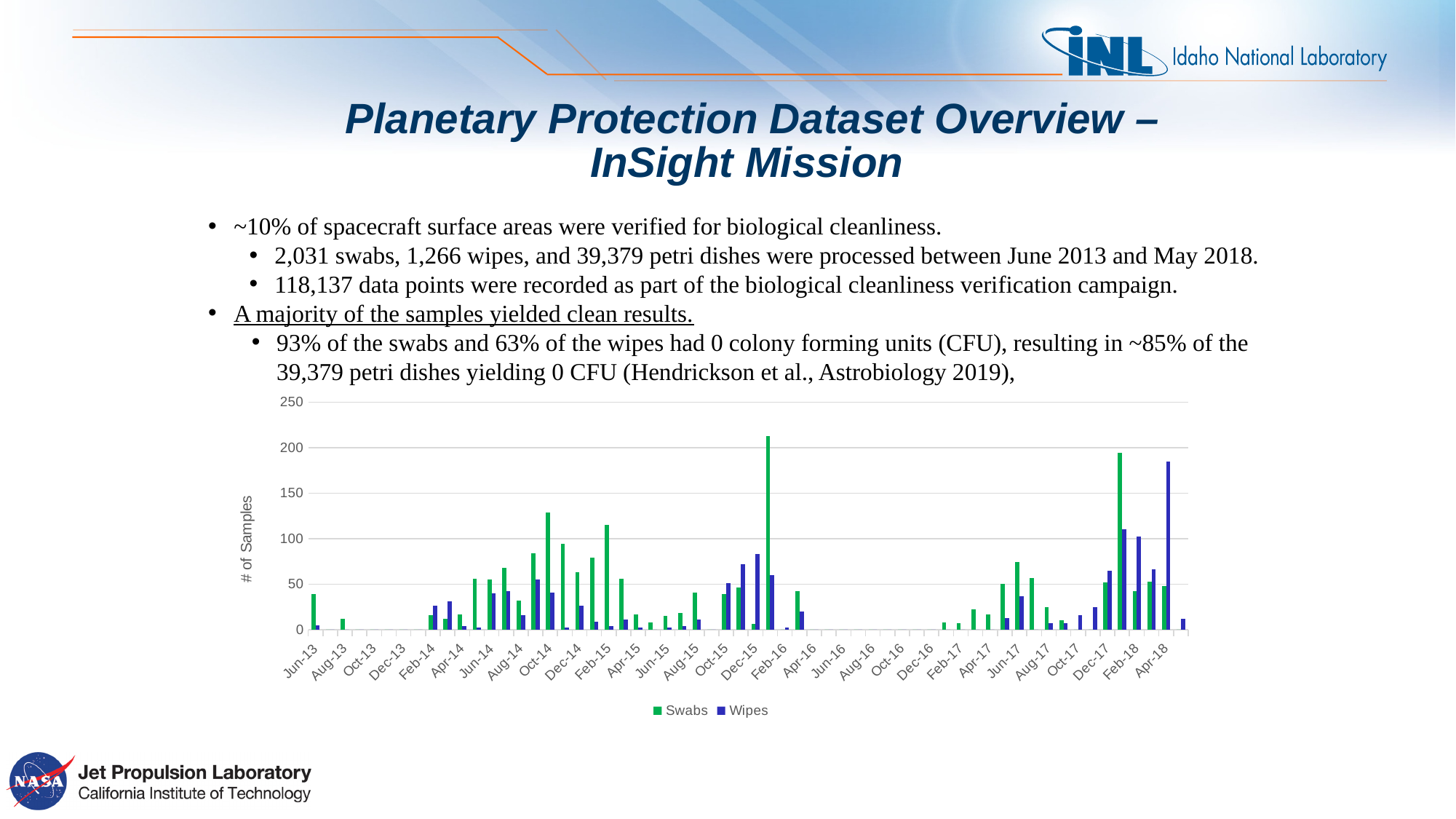
Is the tallest Swabs bar in the chart greater or less than 200? greater At Apr-18, which series has the larger value, Swabs or Wipes? Wipes At Oct-14, which series has the larger value, Swabs or Wipes? Swabs What kind of chart is shown on the slide? bar chart What are the two series named in the chart legend? Swabs and Wipes Is the Wipes value for Dec-15 greater or less than 50? greater Is the Wipes value for Apr-18 greater or less than 150? greater What is the label on the vertical axis of the chart? # of Samples How many series does the chart legend list? 2